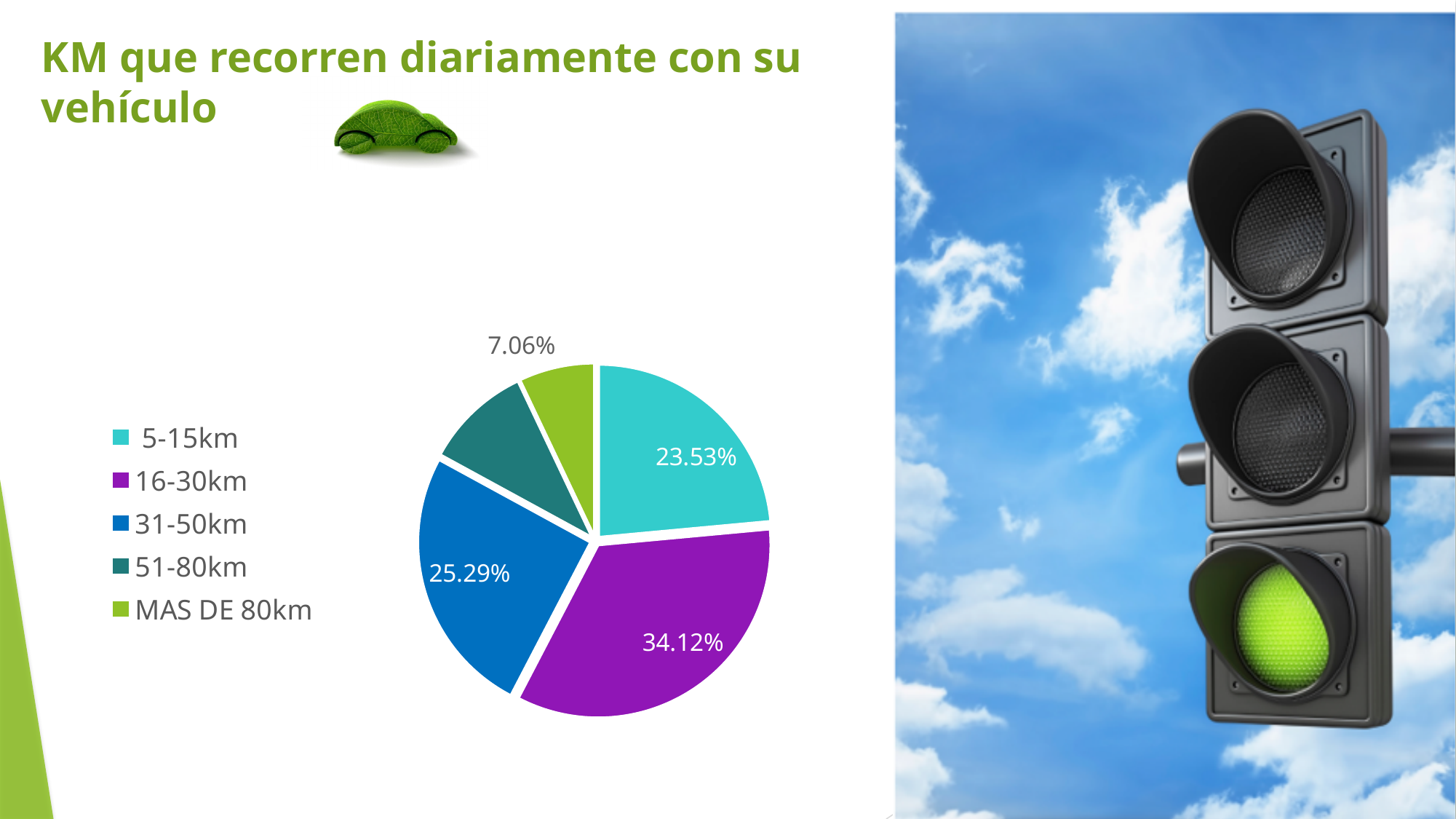
What type of chart is shown on the slide? Pie chart Which slice is larger, 16-30km or 31-50km? 16-30km What percentage of the pie chart corresponds to 31-50km? 25.29% Which category has the largest slice of the pie chart? 16-30km What percentage of the pie chart corresponds to 5-15km? 23.53% Which category has the smallest slice of the pie chart? MAS DE 80km What is the difference in percentage points between the 16-30km slice and the 31-50km slice? 8.83 What is the difference in percentage points between the 16-30km slice and the 5-15km slice? 10.59 What is the title of the slide containing the chart? KM que recorren diariamente con su vehículo What percentage of the pie chart corresponds to MAS DE 80km? 7.06% What percentage of the pie chart corresponds to 16-30km? 34.12% How many categories does the pie chart show? 5